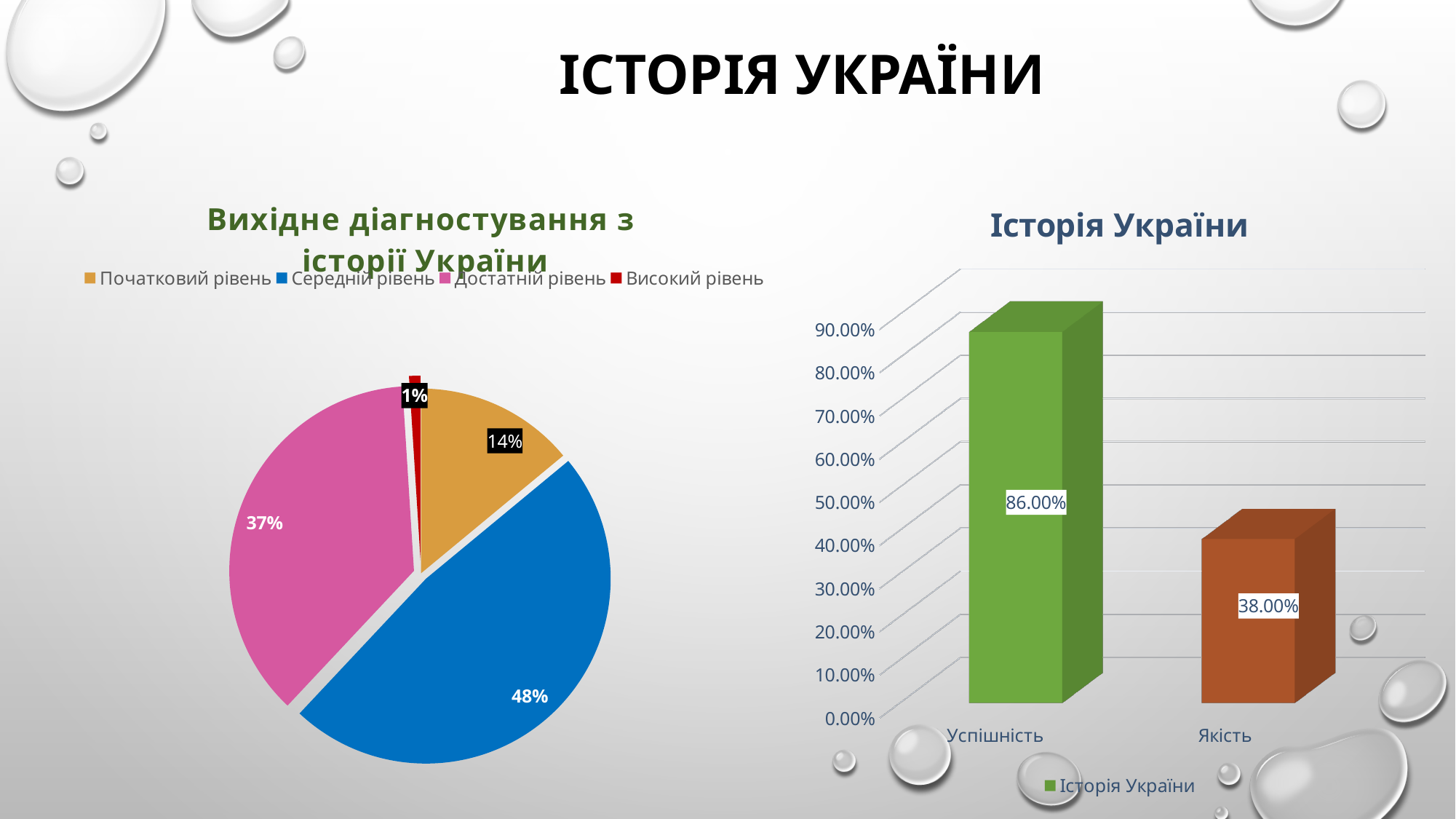
In the pie chart "Вихідне діагностування з історії України", how many slices does the pie have? 4 In the pie chart "Вихідне діагностування з історії України", what share is labelled for Початковий рівень? 14% In the pie chart "Вихідне діагностування з історії України", which level has the largest slice? Середній рівень In the bar chart "Історія України", what is the difference between Успішність and Якість? 48.00% In the pie chart "Вихідне діагностування з історії України", what is the difference between the shares for Середній рівень and Достатній рівень? 11% In the pie chart "Вихідне діагностування з історії України", which colour represents Високий рівень? Red In the bar chart "Історія України", what is the value for Якість? 38.00% In the pie chart "Вихідне діагностування з історії України", what share is labelled for Достатній рівень? 37% What kind of chart is the chart titled "Історія України" on the right of the slide? Bar chart In the pie chart "Вихідне діагностування з історії України", what share is labelled for Середній рівень? 48% In the bar chart "Історія України", what is the value for Успішність? 86.00% In the pie chart "Вихідне діагностування з історії України", which level has the smallest slice? Високий рівень